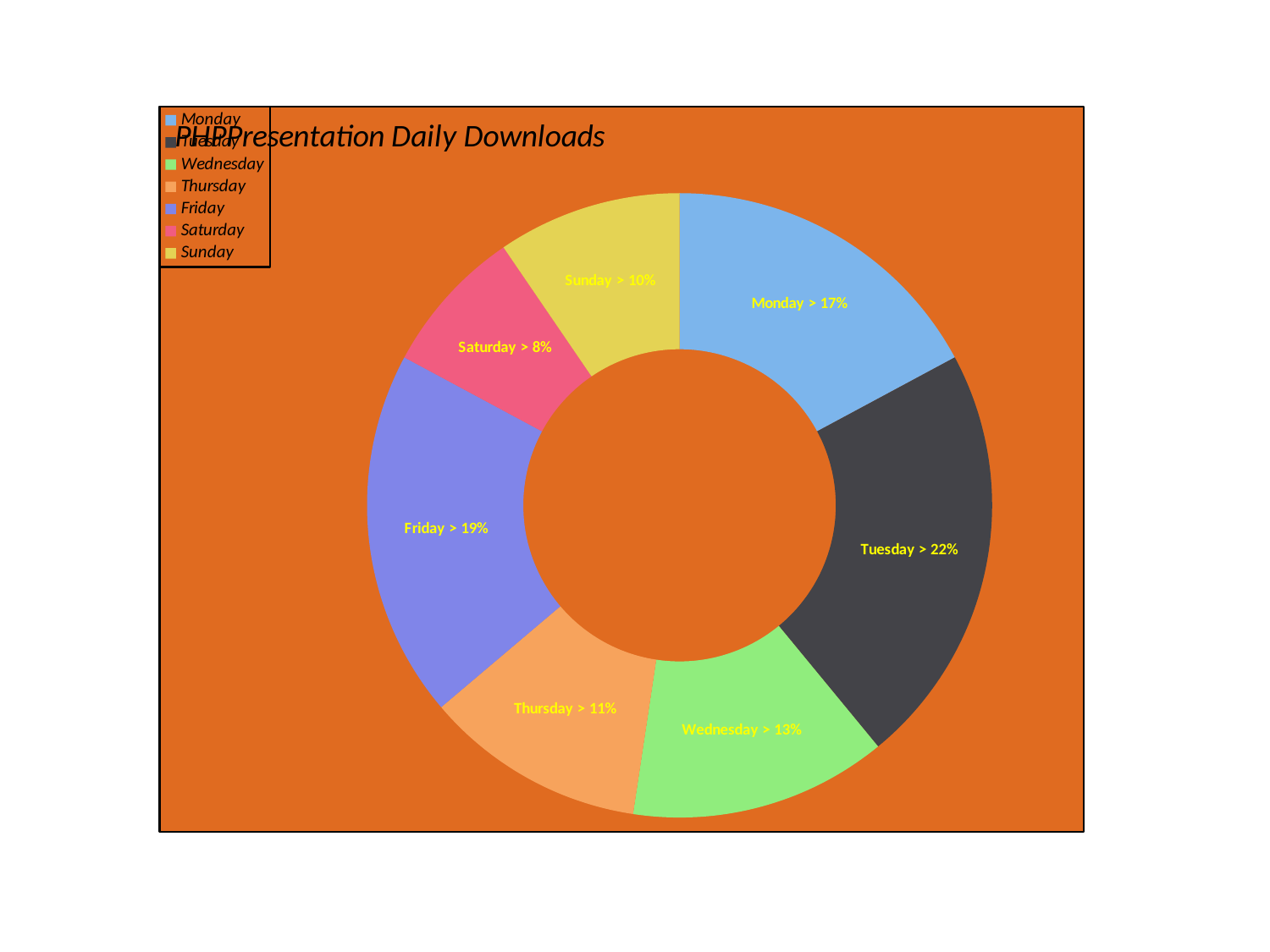
How many days are shown in the chart? 7 Which day has the smallest share of downloads? Saturday Which day has the largest share of downloads? Tuesday What share of daily downloads does Tuesday account for? 22% What is the title of the chart? PHPPresentation Daily Downloads What colour is the Friday segment? Purple/blue Which has a larger share, Thursday or Sunday? Thursday What share of daily downloads does Wednesday account for? 13% What kind of chart is shown on the slide? Doughnut (pie) chart What share of daily downloads does Saturday account for? 8% What is the difference in percentage points between Tuesday's and Monday's shares? 5 What share of daily downloads does Friday account for? 19%